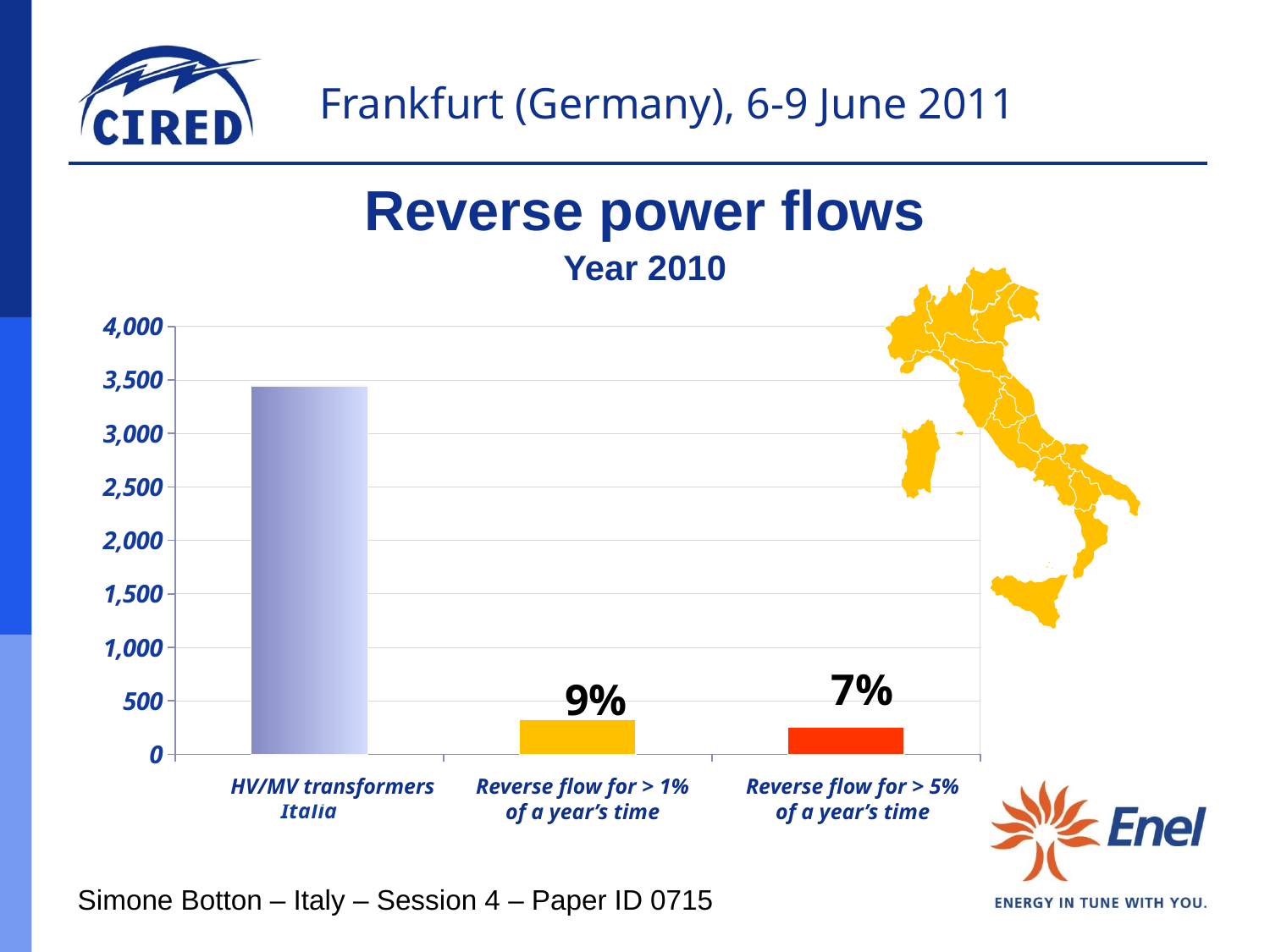
How many categories are plotted in the chart? 3 What percentage label is printed above the bar for Reverse flow for > 1% of a year's time? 9% What percentage label is printed above the bar for Reverse flow for > 5% of a year's time? 7% What kind of chart is shown on the slide? bar chart What colour is the bar for Reverse flow for > 5% of a year's time? red Is the value for Reverse flow for > 1% of a year's time greater or less than 500? less What is the title of the chart? Reverse power flows Is the value for HV/MV transformers Italia greater or less than 3,500? less Is the value for HV/MV transformers Italia greater or less than 3,000? greater Which category has the highest bar in the chart? HV/MV transformers Italia Which bar is taller: Reverse flow for > 1% of a year's time or Reverse flow for > 5% of a year's time? Reverse flow for > 1% of a year's time Which category has the lowest bar in the chart? Reverse flow for > 5% of a year's time